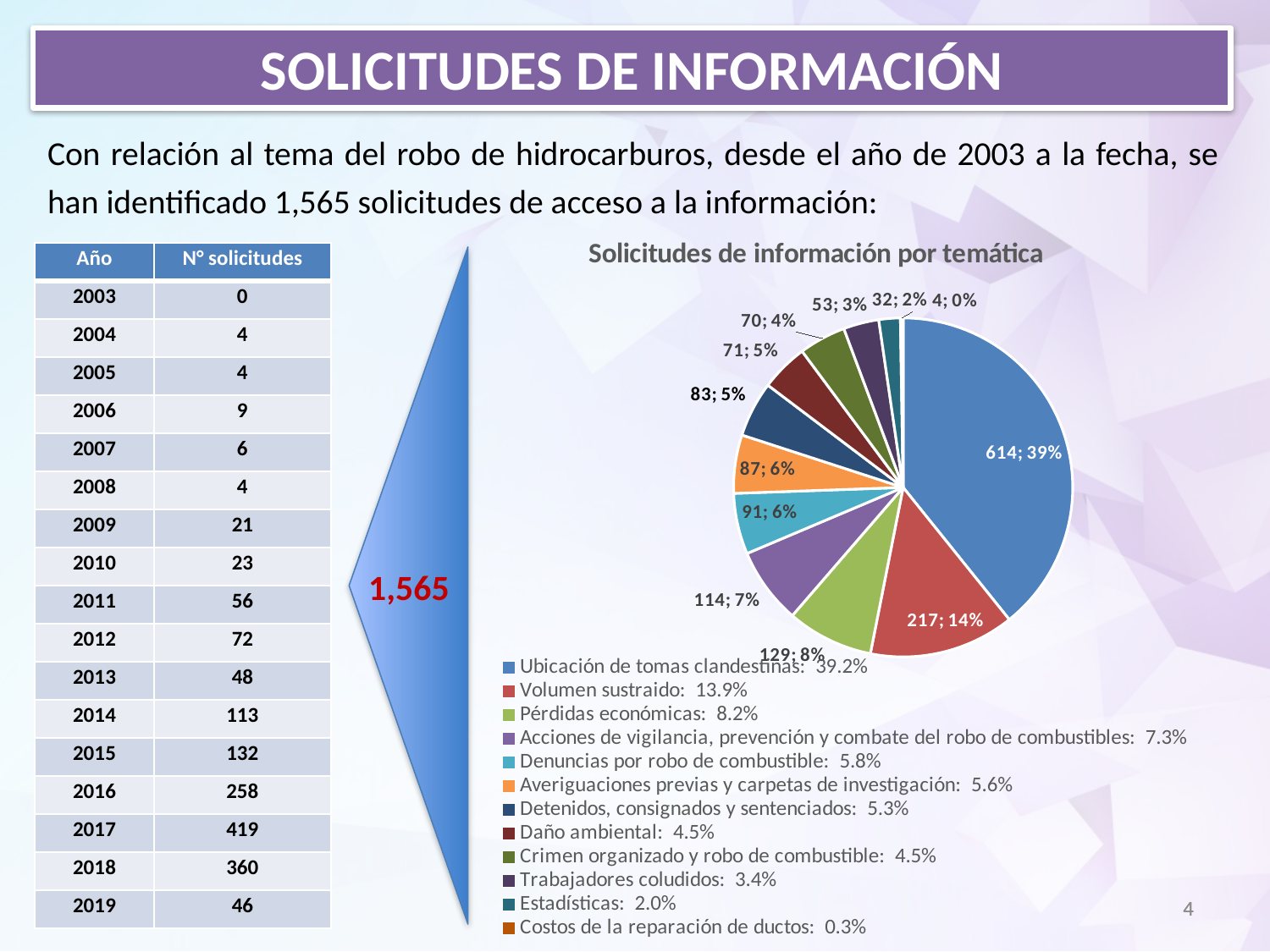
What is the title of the pie chart? Solicitudes de información por temática According to the legend, what percentage share does 'Acciones de vigilancia, prevención y combate del robo de combustibles' have? 7.3% Which category has the largest slice in the pie chart? Ubicación de tomas clandestinas What type of chart is shown on the slide? pie chart Which category has the smallest slice in the pie chart? Costos de la reparación de ductos How many entries does the legend of the pie chart list? 12 How many slices does the pie chart have? 12 What is the number of requests shown for 'Volumen sustraido' in the pie chart? 217 What is the number of requests shown for 'Daño ambiental' in the pie chart? 71 What is the number of requests shown for 'Ubicación de tomas clandestinas' in the pie chart? 614 Which has more requests in the pie chart, 'Pérdidas económicas' or 'Denuncias por robo de combustible'? Pérdidas económicas What is the difference between the number of requests for 'Ubicación de tomas clandestinas' and 'Volumen sustraido'? 397